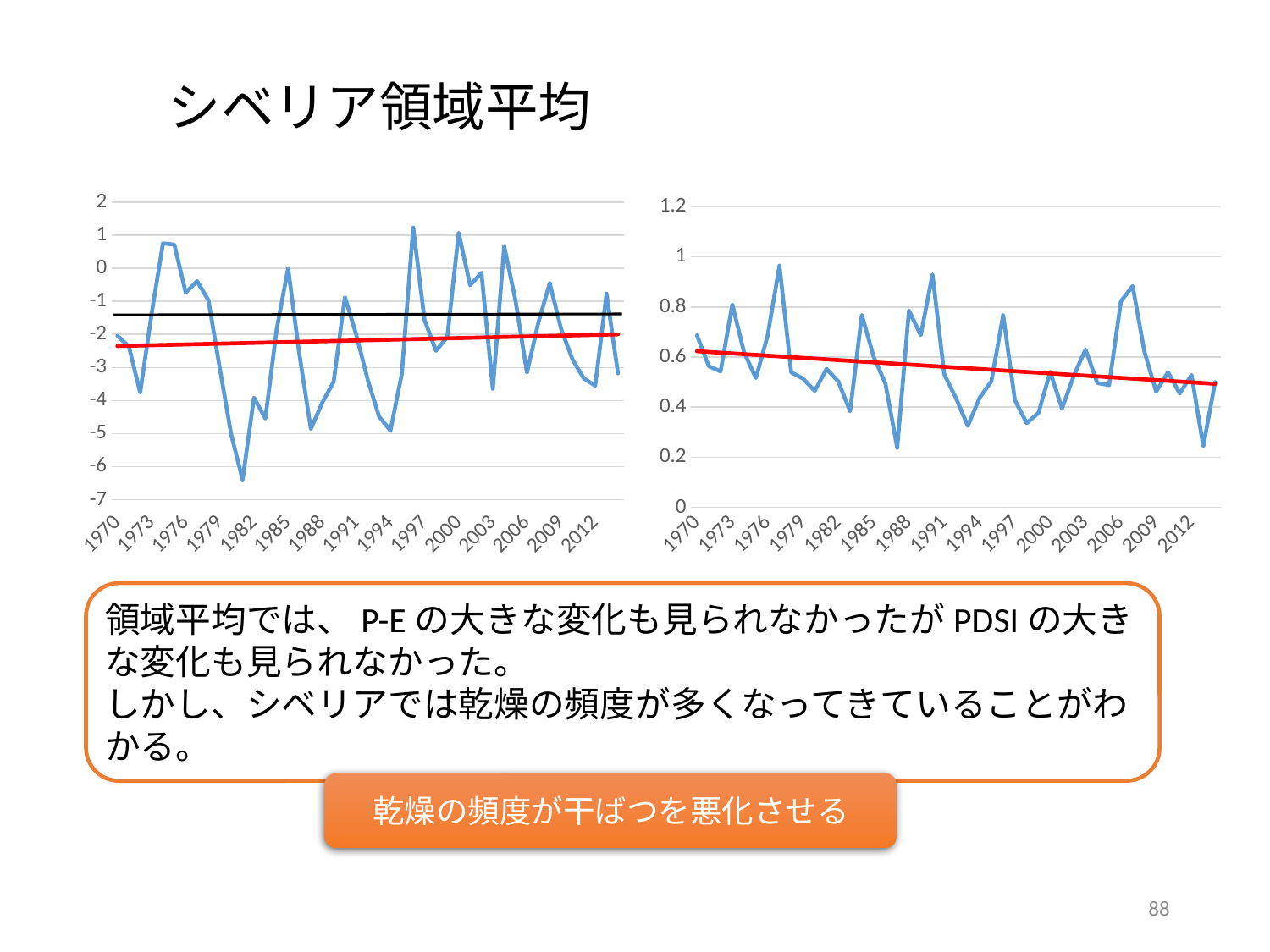
In the right chart, is the value for 1978 greater or less than 0.8? less In the right chart, does the red trend line rise or fall from 1970 to 2012? fall What kind of chart is the left chart on the slide? line chart What kind of chart is the right chart on the slide? line chart In the right chart, is the value for 1988 greater or less than 0.4? greater In the left chart, is the value for 1982 greater or less than -5? greater How many year labels are shown on the x axis of the right chart? 15 In the left chart, does the red trend line rise or fall from 1970 to 2012? rise What is the lowest value shown on the y axis of the left chart? -7 What is the highest value shown on the y axis of the right chart? 1.2